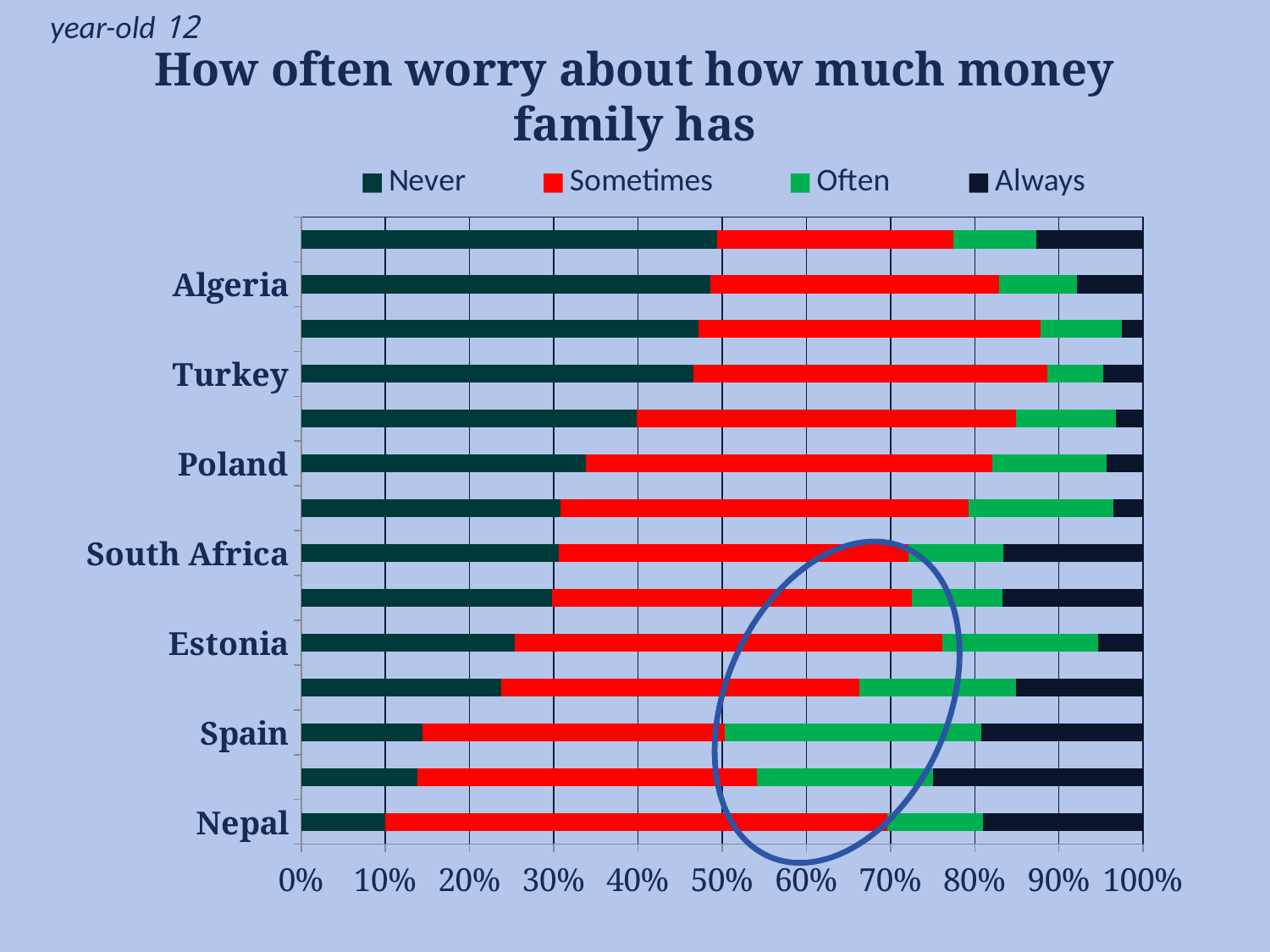
Is the 'Never' share for Nepal greater or less than 20%? less Moving down the chart from Algeria to Nepal, does the 'Never' share rise or fall? fall Is the 'Never' share for Algeria greater or less than 40%? greater What are the four response categories listed in the legend? Never, Sometimes, Often, Always What kind of chart is shown on the slide? Stacked bar chart Which has a larger 'Never' share, Algeria or Nepal? Algeria Is the 'Never' share for Estonia greater or less than 30%? less How many country labels are shown on the vertical axis? 7 What is the title of the chart? How often worry about how much money family has How many series does the legend list? 4 Among the labelled countries, which has the smallest 'Never' share? Nepal